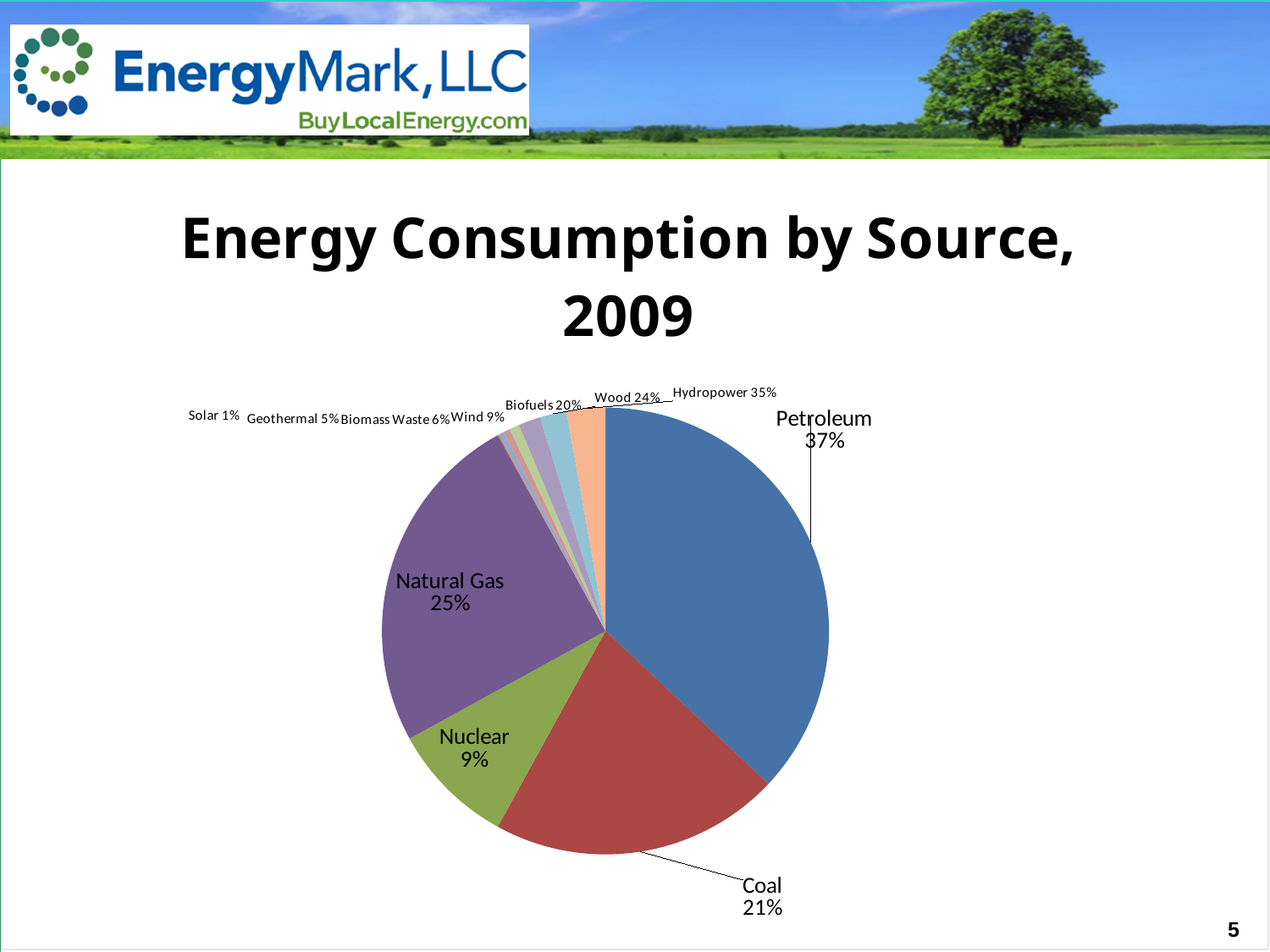
How many energy sources are labelled on the pie chart? 11 What percentage is shown for Natural Gas? 25% What percentage is shown for Solar? 1% Which energy source has the largest slice of the pie? Petroleum Which energy source has the smallest labelled percentage? Solar Which is larger, the Natural Gas slice or the Coal slice? Natural Gas What share of the pie does Petroleum account for? 37% What type of chart is shown on the slide? Pie chart What percentage is shown for Nuclear? 9% What percentage is shown for Coal? 21% What is the difference between the Petroleum and Coal percentages? 16 percentage points What is the title of the chart? Energy Consumption by Source, 2009